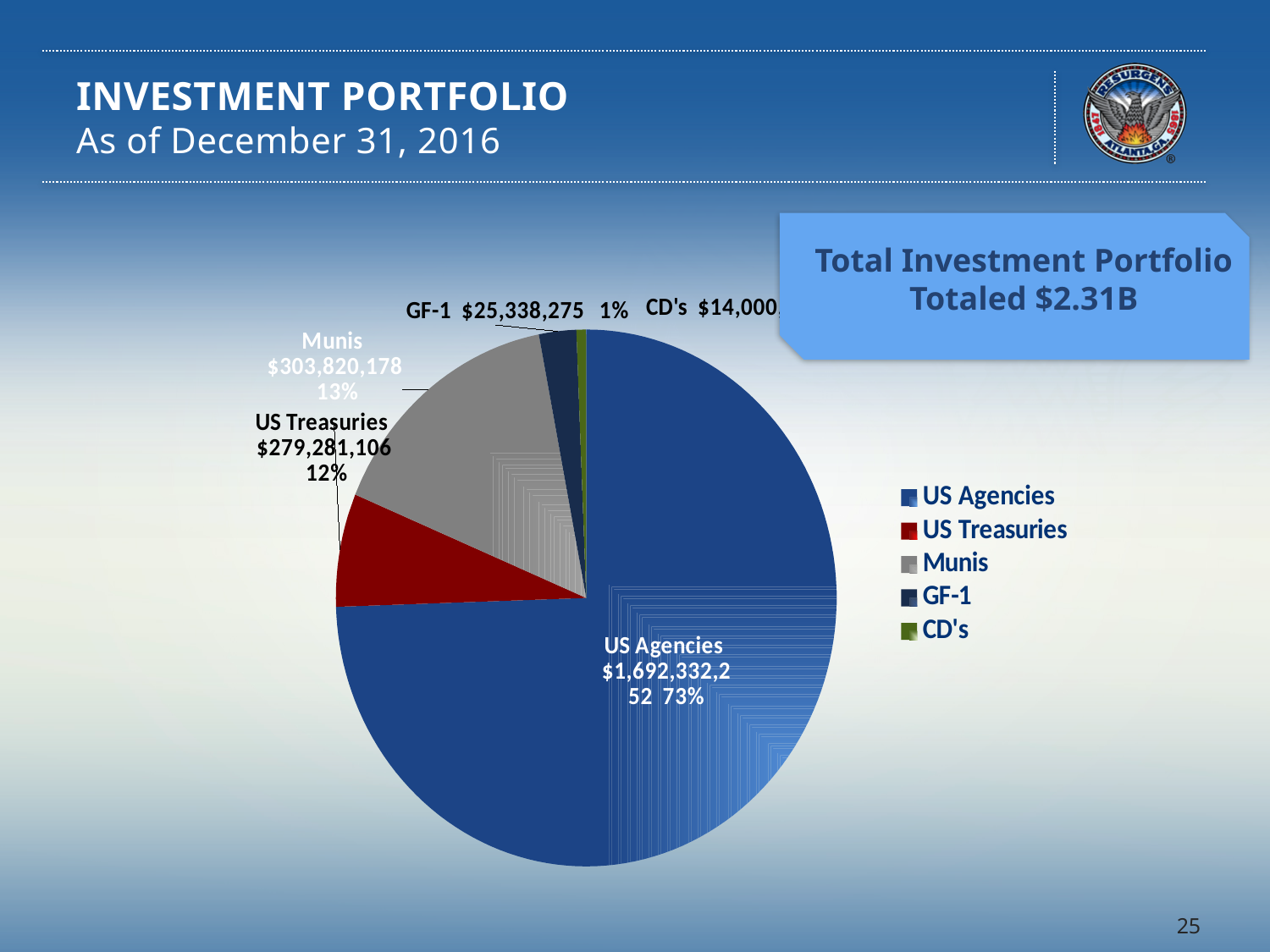
What percentage share of the pie does US Treasuries represent? 12% What percentage share of the pie does US Agencies represent? 73% What kind of chart is shown on the slide? pie chart What is the value shown for US Treasuries in the pie chart? $279,281,106 What is the value shown for GF-1 in the pie chart? $25,338,275 Which category has the largest slice of the pie chart? US Agencies What percentage share of the pie does Munis represent? 13% What is the value shown for Munis in the pie chart? $303,820,178 How many categories does the legend of the pie chart list? 5 Which is larger in the pie chart, Munis or US Treasuries? Munis According to the callout box on the slide, what did the total investment portfolio total? $2.31B Which category has the smallest slice of the pie chart? CD's